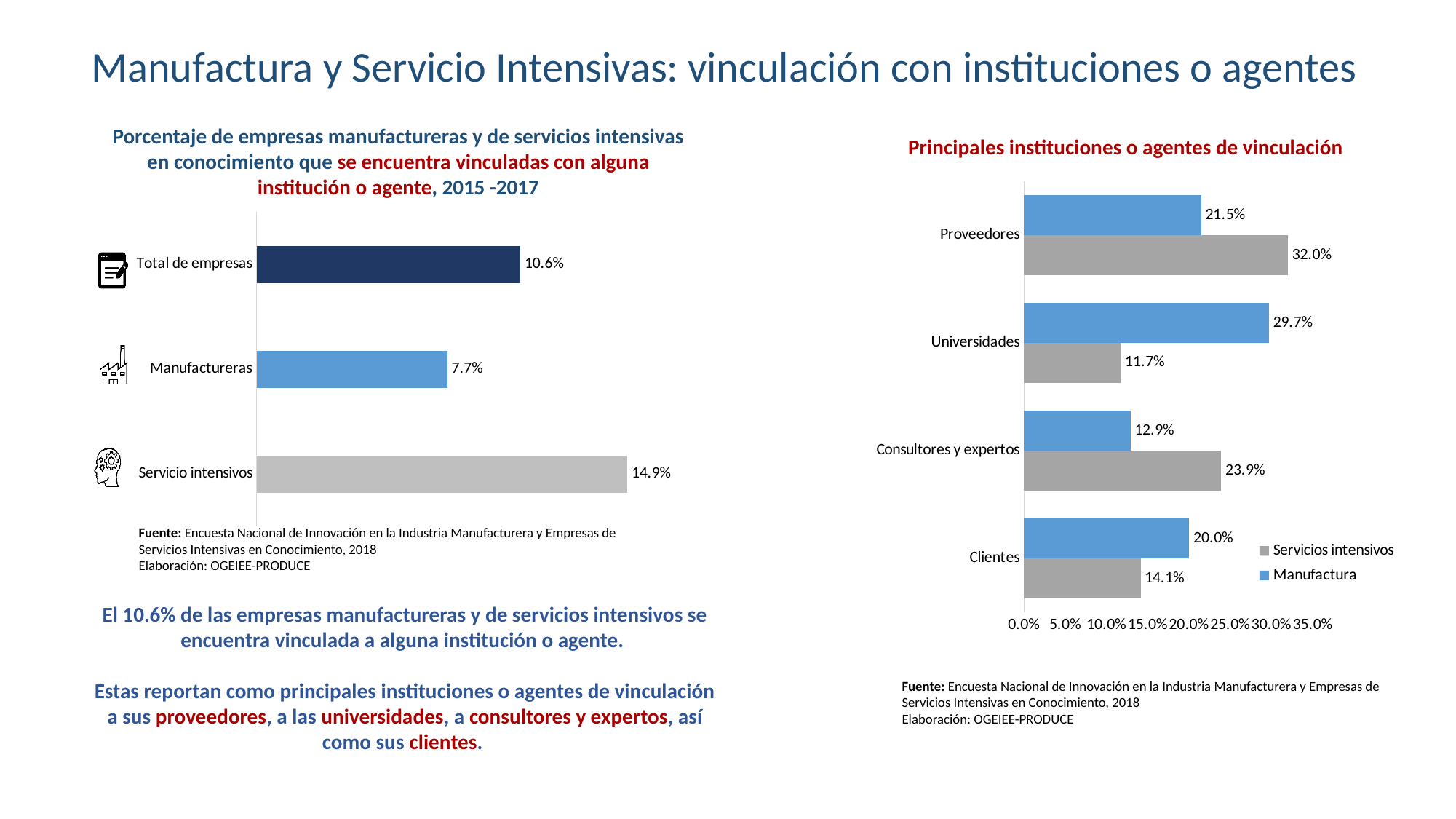
In the right chart, which category has the lowest Manufactura value? Consultores y expertos In the left chart, what is the value for Servicio intensivos? 14.9% In the right chart (Principales instituciones o agentes de vinculación), what is the Manufactura value for Universidades? 29.7% In the right chart, what is the difference between the Servicios intensivos and Manufactura values for Consultores y expertos? 11.0% How many series does the legend of the right chart list? 2 In the left chart, how many categories are shown? 3 In the right chart, for Clientes, which series has the larger value, Manufactura or Servicios intensivos? Manufactura In the right chart, which category has the highest Servicios intensivos value? Proveedores In the left chart, which category has the lowest value? Manufactureras In the right chart, what is the Servicios intensivos value for Proveedores? 32.0% In the left chart, what is the difference between Servicio intensivos and Manufactureras? 7.2% In the left chart (Porcentaje de empresas ... vinculadas con alguna institución o agente, 2015-2017), what is the value for Total de empresas? 10.6%